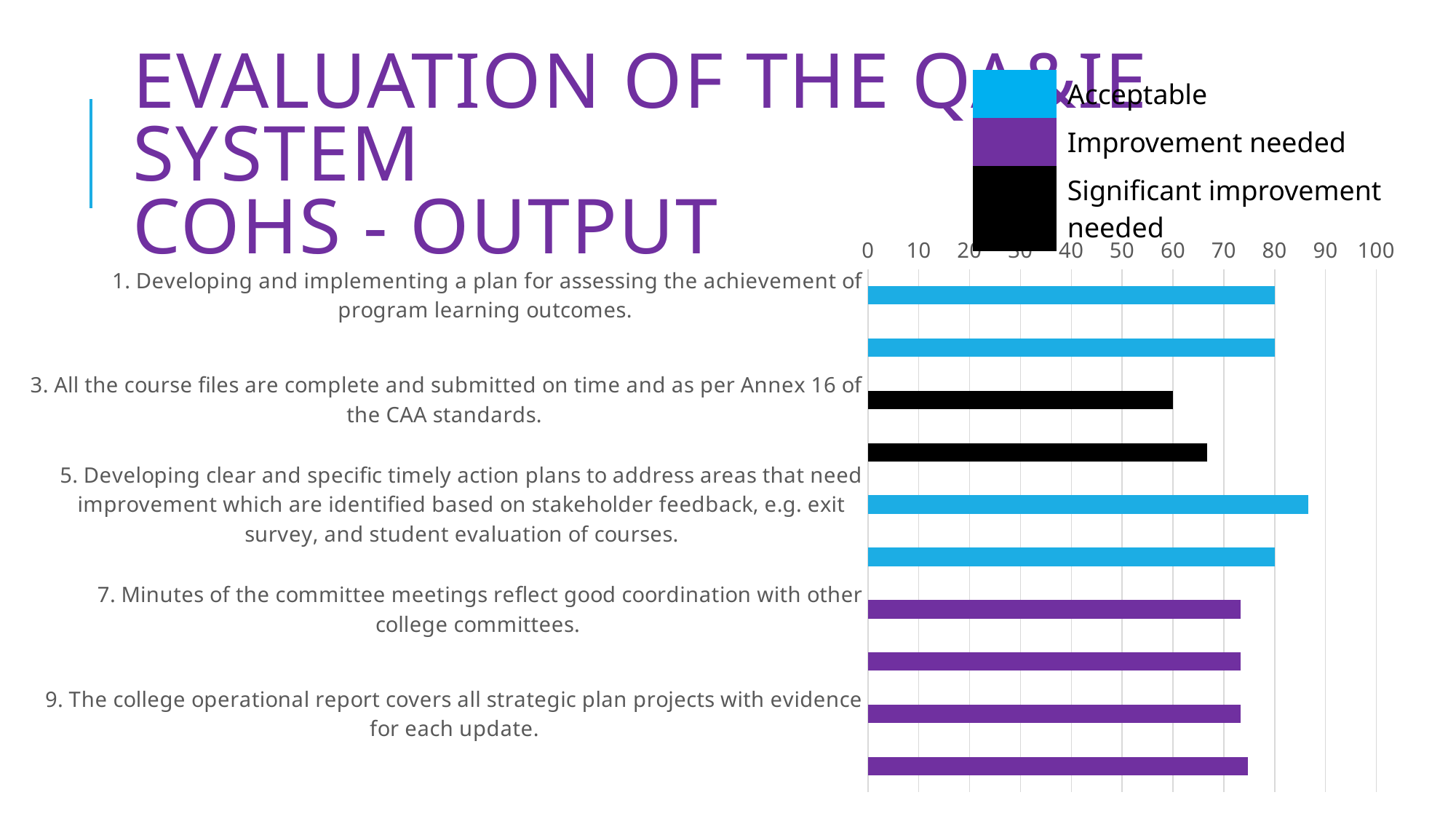
Which labelled item has the shortest bar? 3. All the course files are complete and submitted on time and as per Annex 16 of the CAA standards Which legend category does the bar for item 1 (Developing and implementing a plan for assessing the achievement of program learning outcomes) belong to? Acceptable Is the value for item 5 (Developing clear and specific timely action plans) greater or less than 80? greater How many entries does the chart legend list? 3 Which has the larger value, item 1 (plan for assessing program learning outcomes) or item 3 (course files complete and submitted on time)? item 1 What is the value for item 3, All the course files are complete and submitted on time and as per Annex 16 of the CAA standards? 60 Which legend entry is shown in black? Significant improvement needed What is the value for item 1, Developing and implementing a plan for assessing the achievement of program learning outcomes? 80 What kind of chart is shown on the slide? bar chart Is the value for item 7 (Minutes of the committee meetings reflect good coordination with other college committees) greater or less than 80? less Is the value for item 9 (The college operational report covers all strategic plan projects) greater or less than 70? greater Which labelled item has the longest bar? 5. Developing clear and specific timely action plans to address areas that need improvement